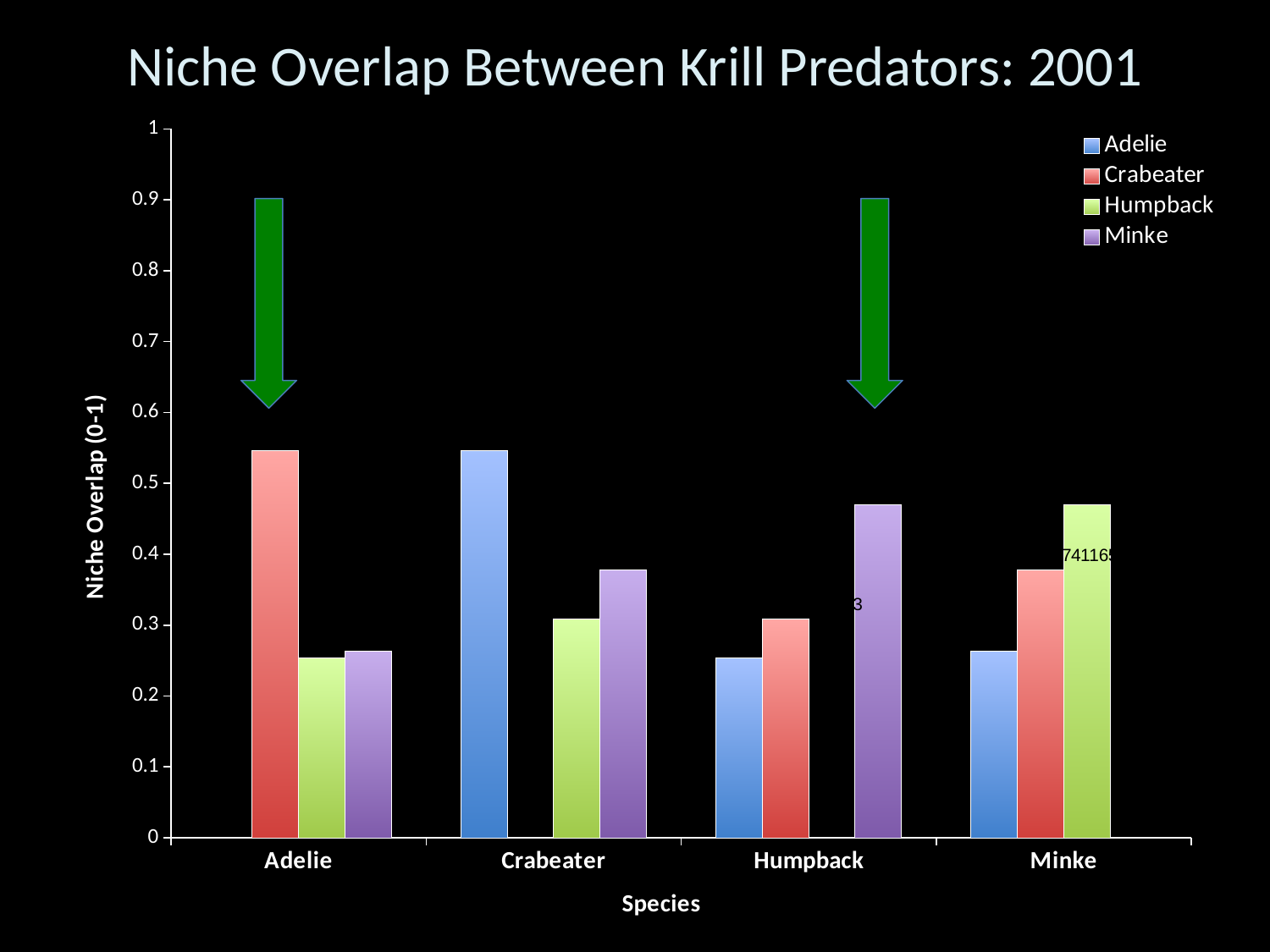
In the Minke category, which series has the lowest value? Adelie What is the title of the y axis? Niche Overlap (0-1) What kind of chart is shown on the slide? bar chart Is the Adelie value in the Minke category greater or less than 0.3? less In the Minke category, which is larger: the Humpback value or the Crabeater value? Humpback Is the Crabeater value in the Adelie category greater or less than 0.5? greater Is the Humpback value in the Crabeater category greater or less than 0.4? less In the Crabeater category, which is larger: the Adelie value or the Minke value? Adelie How many series does the legend list? 4 How many species categories are shown on the x axis? 4 In the Humpback category, which series has the highest value? Minke